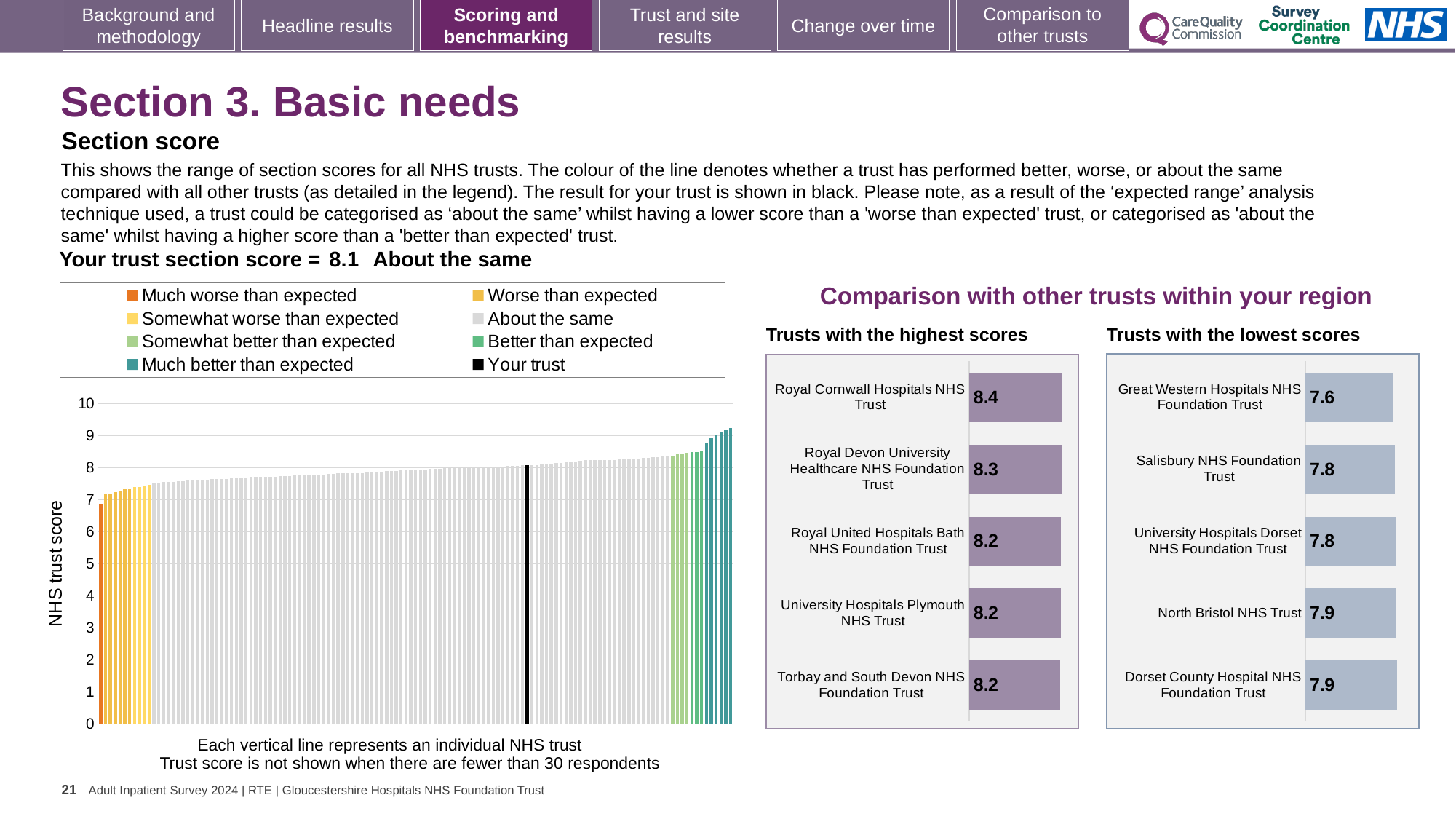
In the main NHS trust score chart on the left, what is the section score for your trust (the black bar)? 8.1 In the 'Trusts with the lowest scores' chart, what is the score for Great Western Hospitals NHS Foundation Trust? 7.6 In the 'Trusts with the highest scores' chart, which trust has the highest score? Royal Cornwall Hospitals NHS Trust In the 'Trusts with the lowest scores' chart, what is the score for North Bristol NHS Trust? 7.9 What is the difference between the score for Royal Cornwall Hospitals NHS Trust in the highest scores chart and the score for Great Western Hospitals NHS Foundation Trust in the lowest scores chart? 0.8 In the 'Trusts with the lowest scores' chart, which trust has the lowest score? Great Western Hospitals NHS Foundation Trust How many entries does the legend of the main NHS trust score chart on the left list? 8 In the 'Trusts with the highest scores' chart, what is the score for Royal Cornwall Hospitals NHS Trust? 8.4 In the 'Trusts with the lowest scores' chart, which has the larger score: Salisbury NHS Foundation Trust or Dorset County Hospital NHS Foundation Trust? Dorset County Hospital NHS Foundation Trust In the 'Trusts with the highest scores' chart, what is the score for Royal Devon University Healthcare NHS Foundation Trust? 8.3 How many trusts are listed in the 'Trusts with the highest scores' chart? 5 In the main NHS trust score chart on the left, is the value of the tallest bar greater or less than 9? greater